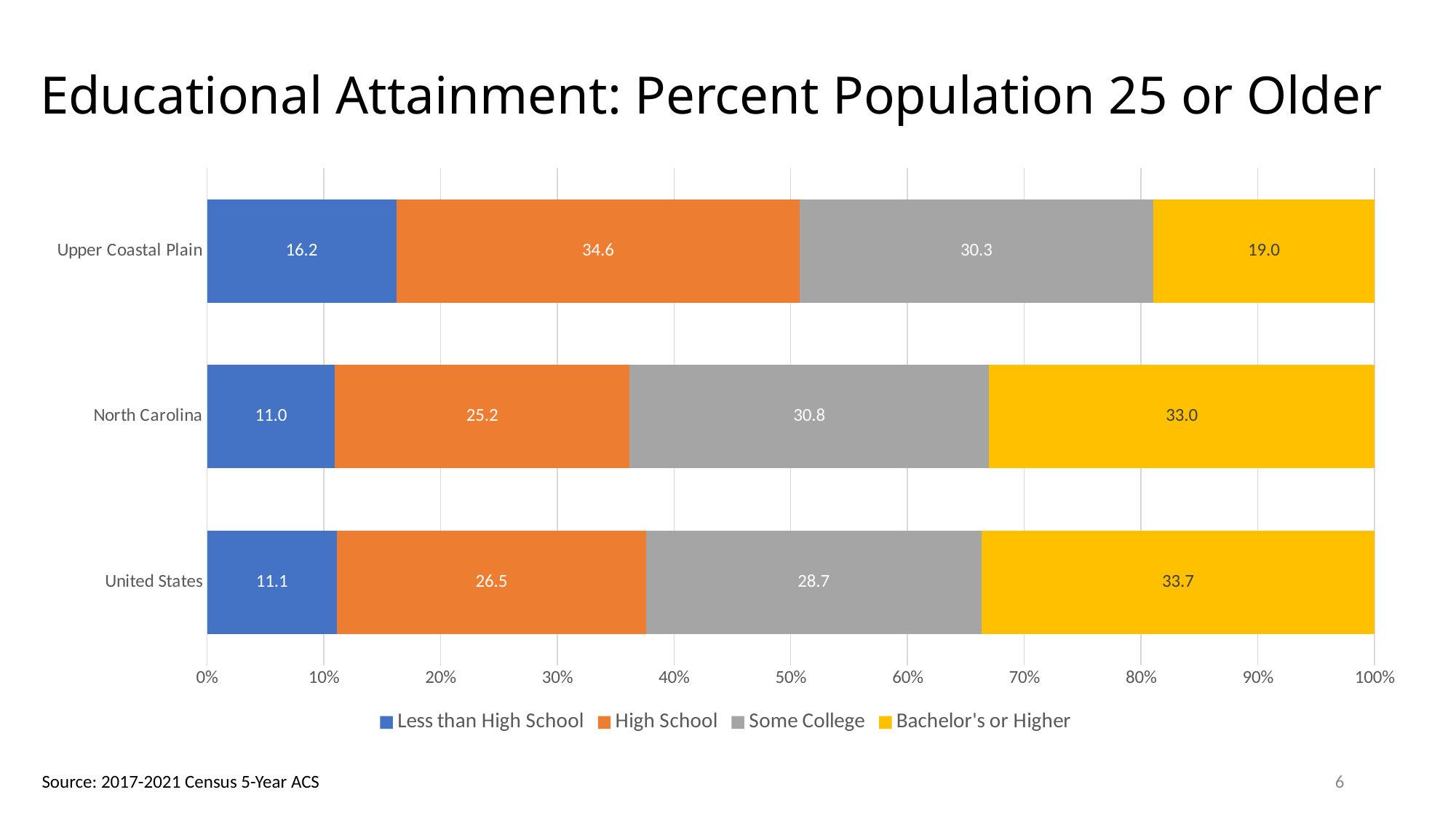
Which is larger: the Less than High School value for the Upper Coastal Plain or for North Carolina? Upper Coastal Plain Which category has the highest value for Bachelor's or Higher? United States What kind of chart is shown on the slide? Stacked bar chart Which colour represents Some College in the legend? Gray What is the difference between the Bachelor's or Higher values for the United States and the Upper Coastal Plain? 14.7 What is the value for Bachelor's or Higher in North Carolina? 33.0 How many categories are shown on the y axis? 3 What is the title of the chart? Educational Attainment: Percent Population 25 or Older How many series does the legend list? 4 Which category has the lowest value for High School? North Carolina What is the value for High School in the Upper Coastal Plain? 34.6 What is the value for Less than High School in the United States? 11.1